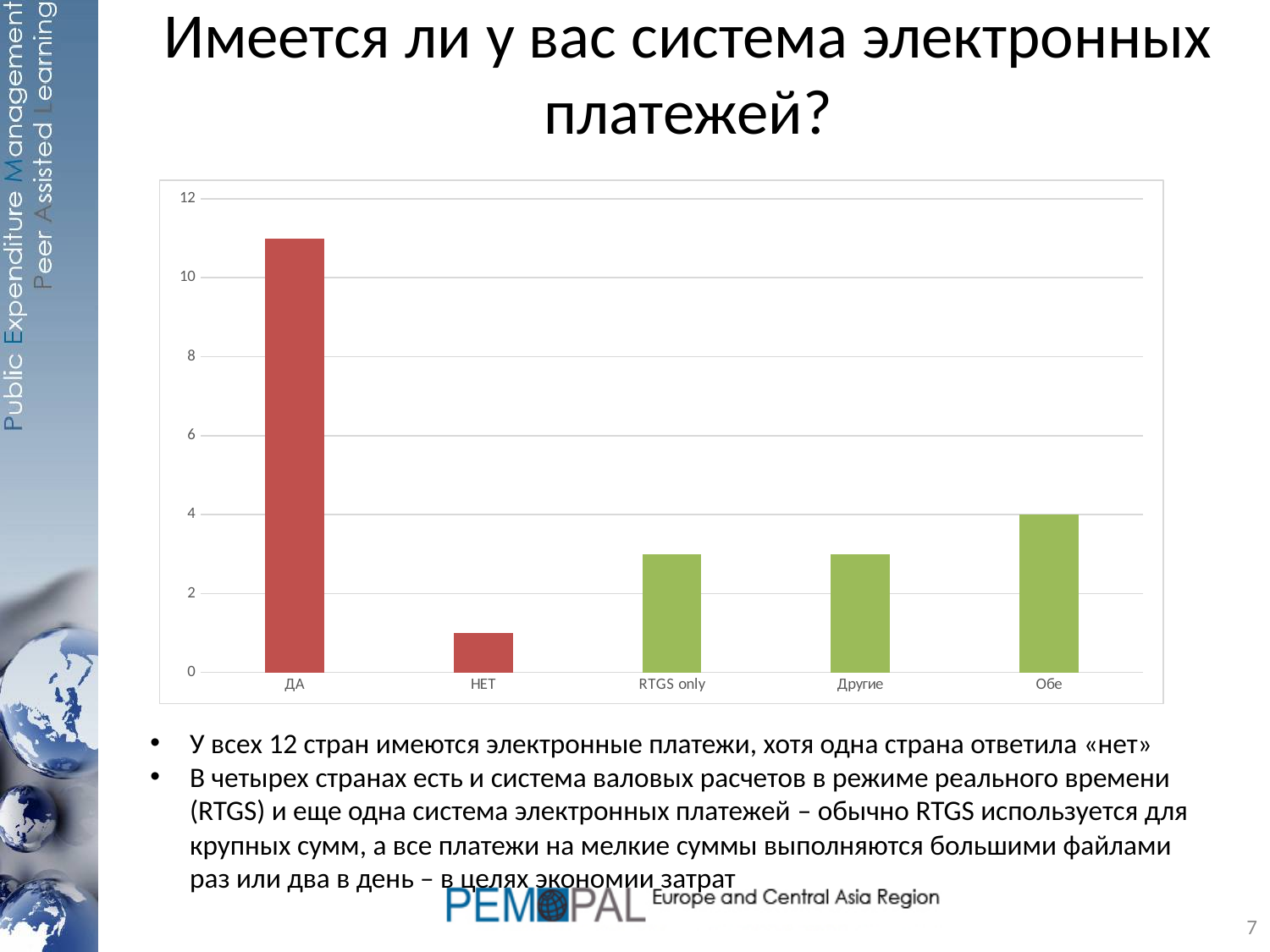
Is the value for НЕТ greater or less than 2? less What kind of chart is shown on the slide? bar chart What is the value for Обе in the chart? 4 Is the value for Другие greater or less than 2? greater Which category has the highest bar in the chart? ДА What colour are the bars for ДА and НЕТ in the chart? red Which is larger, the value for ДА or the value for Обе? ДА Which is larger, the value for Обе or the value for Другие? Обе Is the value for ДА greater or less than 10? greater Which category has the lowest bar in the chart? НЕТ How many categories are shown on the x axis of the chart? 5